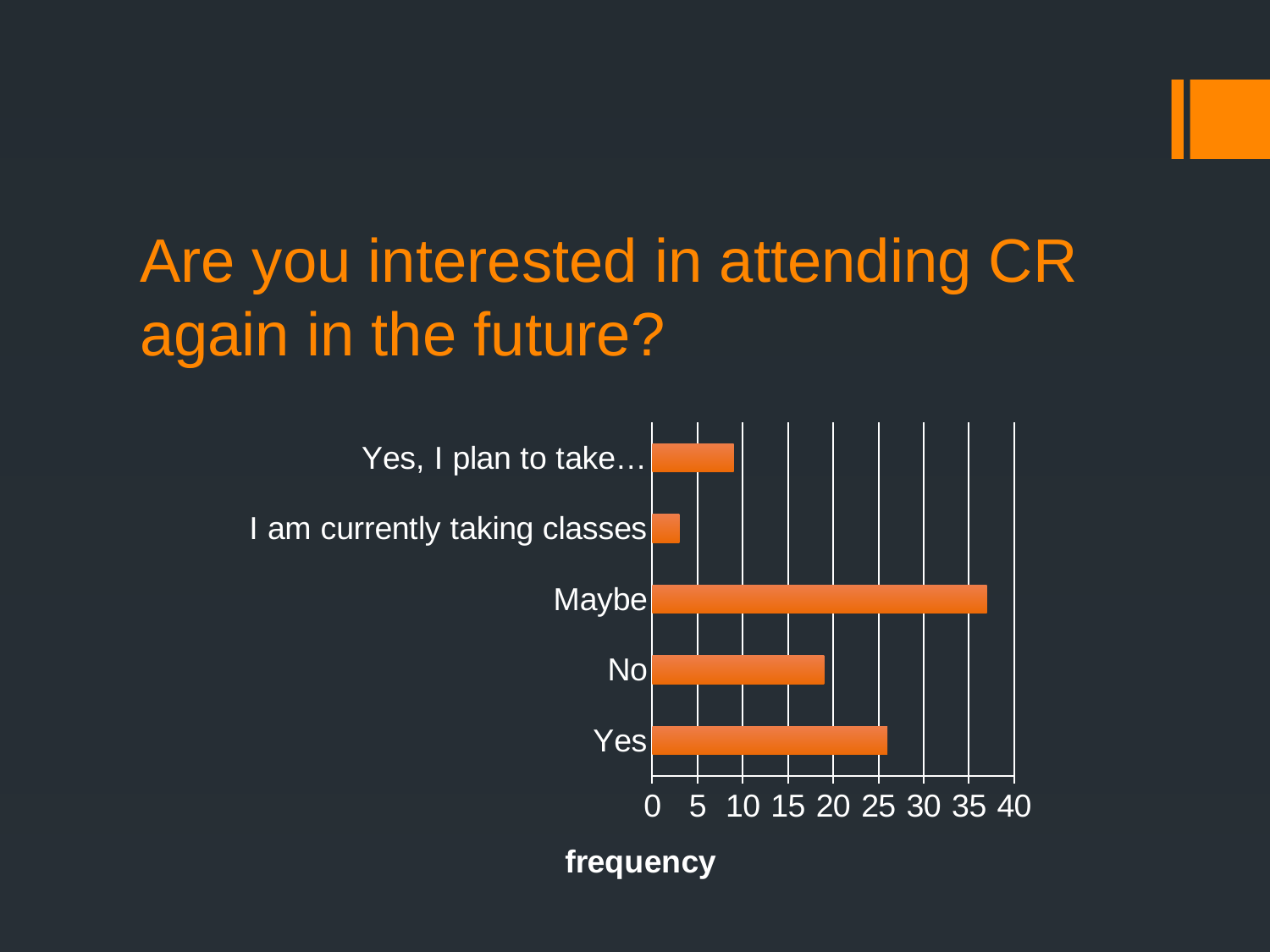
What colour are the bars in the chart? orange Is the value for Yes greater or less than 20? greater Is the value for No greater or less than 15? greater Is the value for I am currently taking classes greater or less than 5? less Which has a higher frequency, Maybe or Yes? Maybe What is the label on the horizontal axis of the chart? frequency How many categories are plotted in the chart? 5 Which category has the highest frequency? Maybe Which category has the lowest frequency? I am currently taking classes Which has a higher frequency, Yes or No? Yes What kind of chart is shown on the slide? bar chart